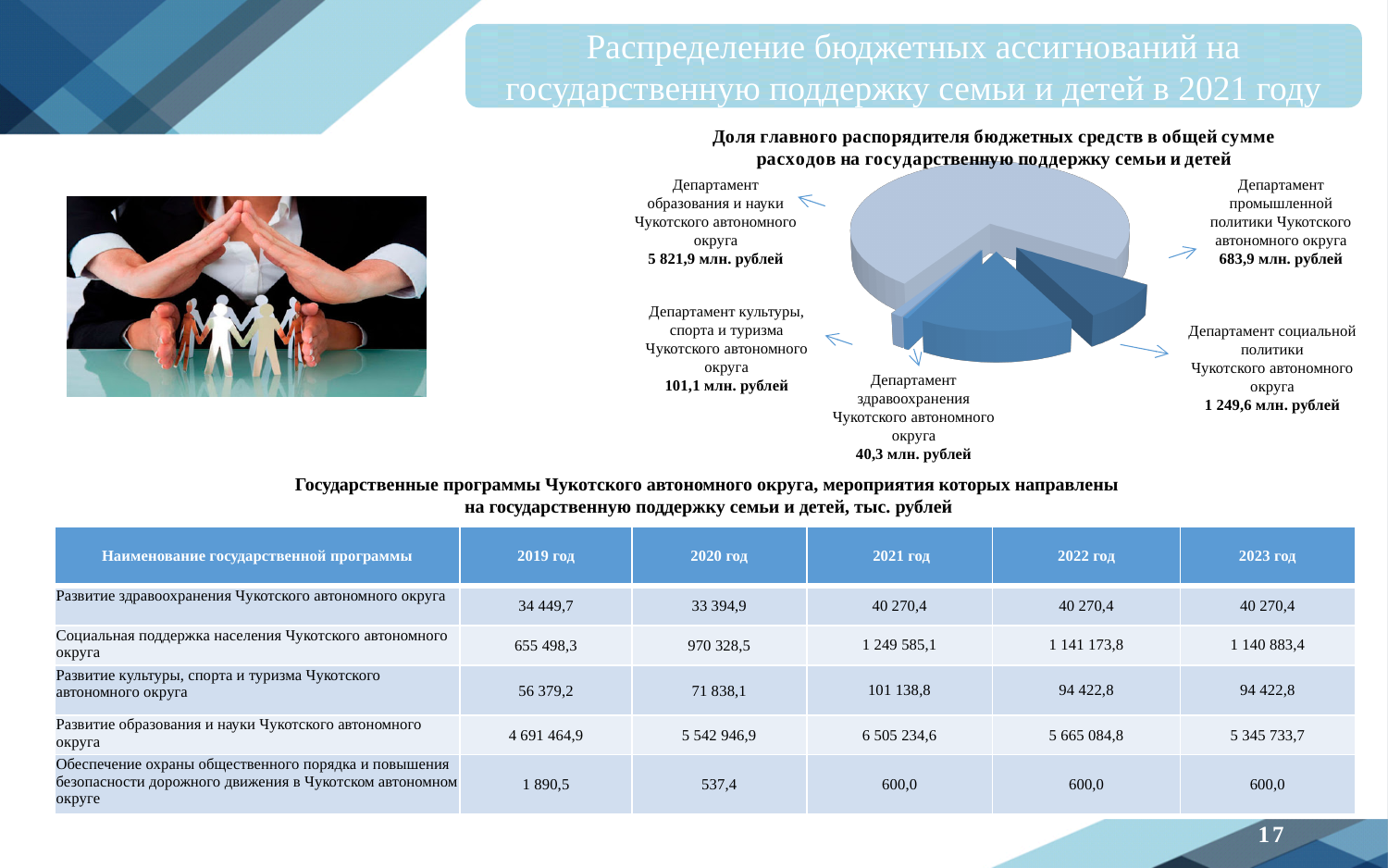
Which department has the largest slice in the pie chart? Департамент образования и науки Чукотского автономного округа How many slices (departments) does the pie chart show? 5 In the pie chart, what is the value for Департамент социальной политики Чукотского автономного округа? 1 249,6 млн. рублей In the pie chart, which is larger: the value for Департамент социальной политики or for Департамент промышленной политики? Департамент социальной политики In the pie chart, what is the value for Департамент здравоохранения Чукотского автономного округа? 40,3 млн. рублей What kind of chart is shown under the title «Доля главного распорядителя бюджетных средств в общей сумме расходов на государственную поддержку семьи и детей»? Pie chart In the pie chart, what is the difference between the values for Департамент образования и науки and Департамент социальной политики? 4 572,3 млн. рублей In the pie chart, what is the value for Департамент образования и науки Чукотского автономного округа? 5 821,9 млн. рублей Which department has the smallest slice in the pie chart? Департамент здравоохранения Чукотского автономного округа In the pie chart, what is the difference between the values for Департамент культуры, спорта и туризма and Департамент здравоохранения? 60,8 млн. рублей In the pie chart, what is the value for Департамент культуры, спорта и туризма Чукотского автономного округа? 101,1 млн. рублей In the pie chart, what is the value for Департамент промышленной политики Чукотского автономного округа? 683,9 млн. рублей